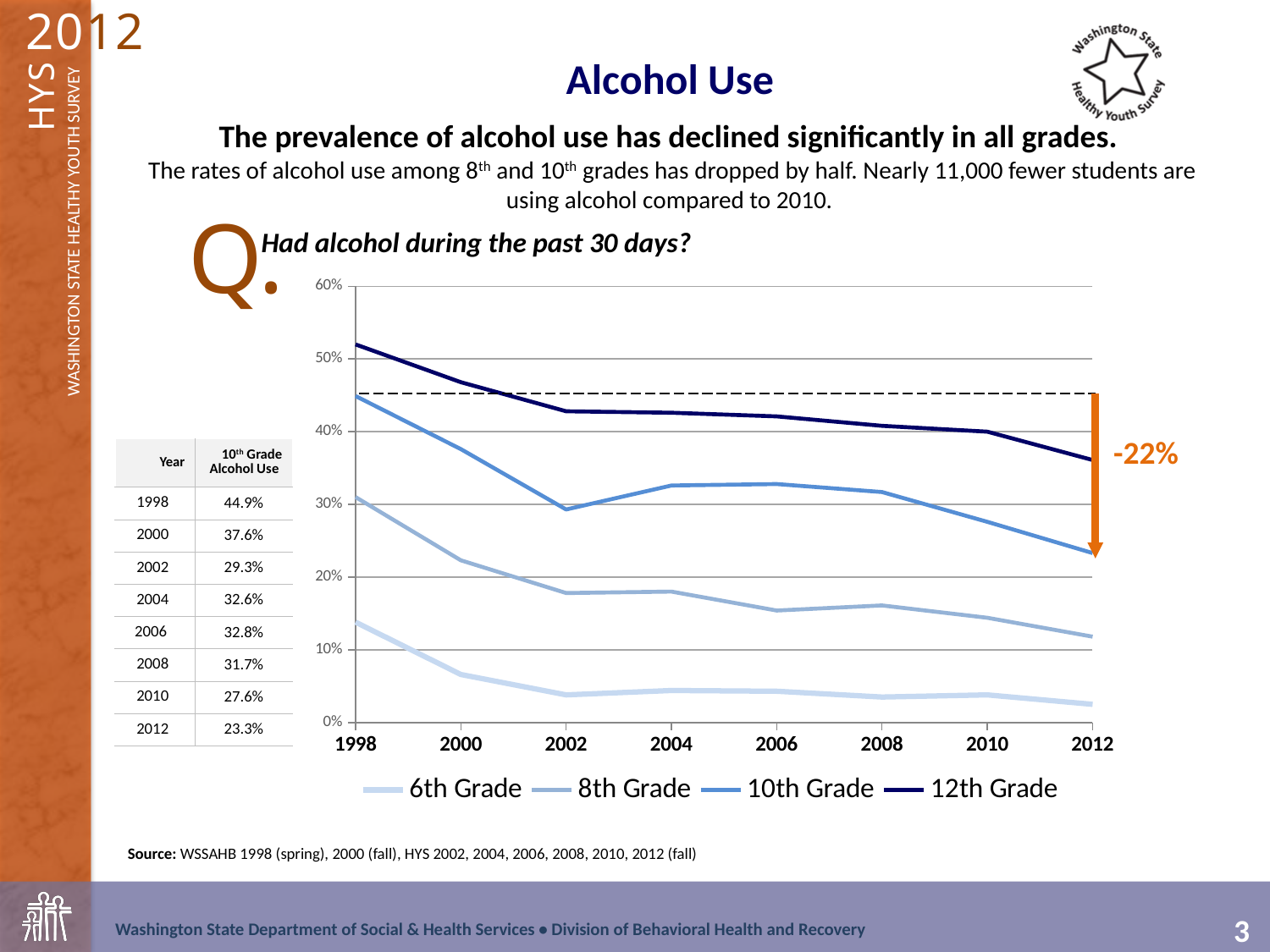
Is the value for 12th Grade in 2012 greater or less than 40%? less How many series does the chart legend list? 4 Is the value for 6th Grade in 1998 greater or less than 10%? greater Is the value for 12th Grade in 1998 greater or less than 50%? greater Does the 12th Grade line rise or fall from 1998 to 2012? fall Which grade has the lowest alcohol use in 1998? 6th Grade What kind of chart is shown on the slide? line chart Which grade has the highest alcohol use in 2012? 12th Grade According to the table, what was the 10th Grade alcohol use in 2012? 23.3% How many years are plotted along the x axis of the chart? 8 Which is larger for 10th Grade alcohol use: the value in 2002 or the value in 2004? 2004